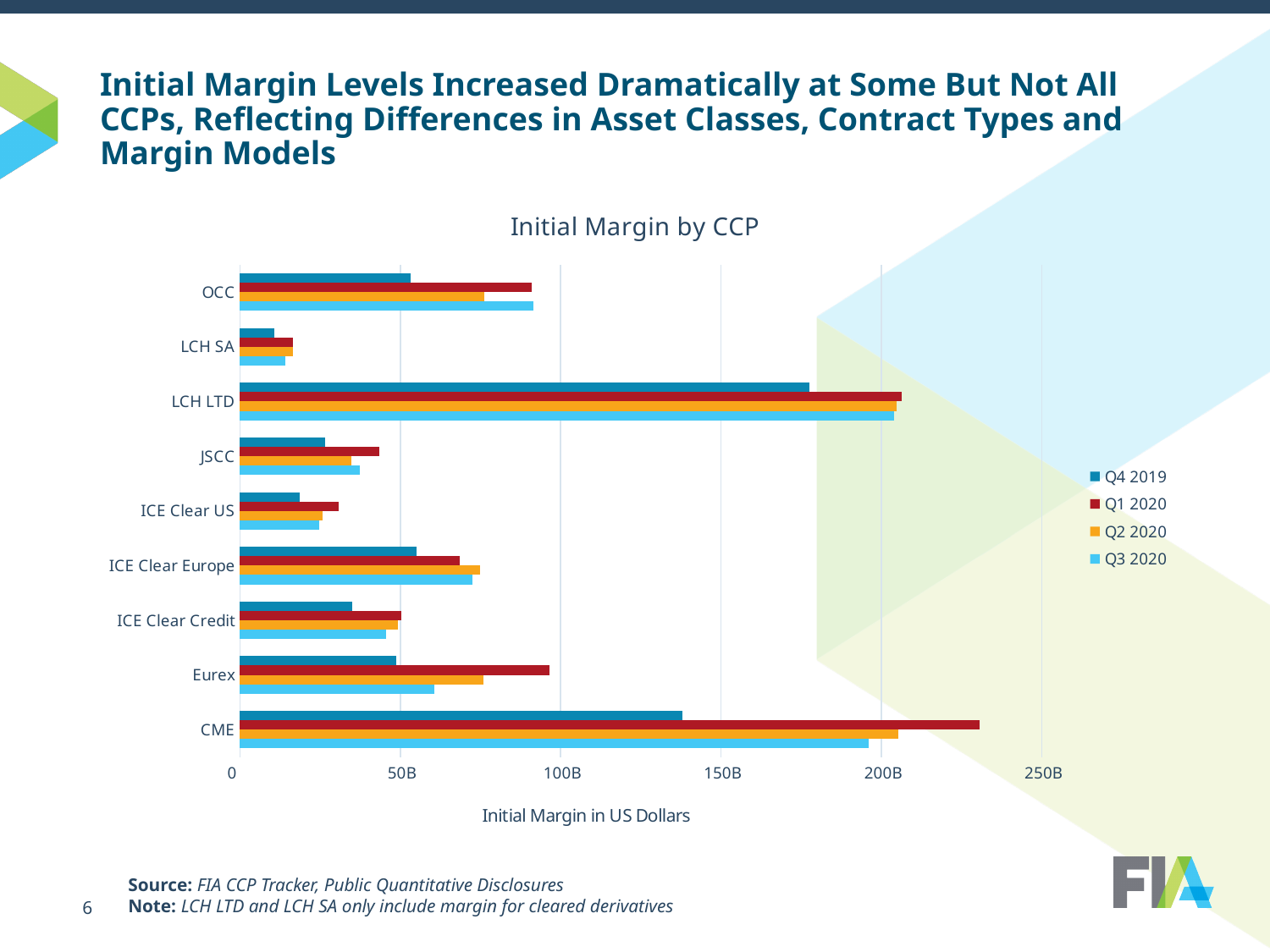
What kind of chart is shown on the slide? bar chart Which CCP has the highest Q1 2020 initial margin? CME Is the Q3 2020 value for LCH SA greater or less than 50B? less What is the label on the horizontal axis? Initial Margin in US Dollars How many series does the legend list? 4 How many CCPs are shown on the chart? 9 Which CCP has the lowest Q4 2019 initial margin? LCH SA Which CCP has the highest Q4 2019 initial margin? LCH LTD What is the title of the chart? Initial Margin by CCP Is the Q1 2020 value for CME greater or less than 200B? greater Is the Q4 2019 value for LCH LTD greater or less than 150B? greater Which is larger for Q1 2020: CME or LCH LTD? CME